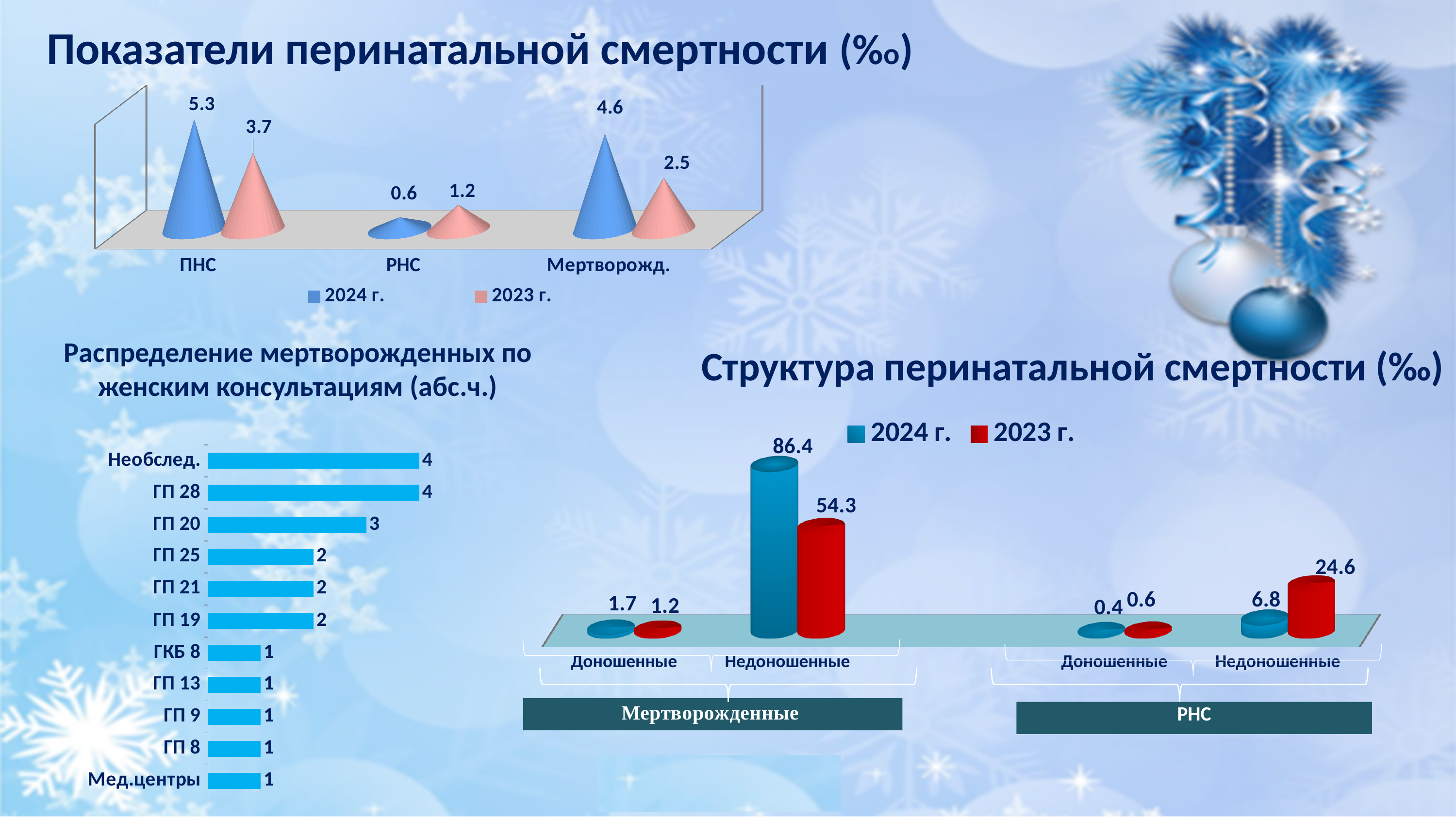
In the chart 'Структура перинатальной смертности (‰)', what is the difference between the 2024 г. and 2023 г. values for Недоношенные under Мертворожденные? 32.1 In the chart 'Распределение мертворожденных по женским консультациям (абс.ч.)', how many categories are shown? 11 In the chart 'Структура перинатальной смертности (‰)', what is the 2023 г. value for Недоношенные under РНС? 24.6 In the chart 'Показатели перинатальной смертности (‰)', which category has the lowest value for 2024 г.? РНС What kind of chart is 'Распределение мертворожденных по женским консультациям (абс.ч.)'? Bar chart In the chart 'Показатели перинатальной смертности (‰)', how many series does the legend list? 2 In the chart 'Показатели перинатальной смертности (‰)', what is the value for ПНС in 2024 г.? 5.3 In the chart 'Распределение мертворожденных по женским консультациям (абс.ч.)', what is the value for ГП 20? 3 In the chart 'Структура перинатальной смертности (‰)', what is the 2024 г. value for Недоношенные under Мертворожденные? 86.4 In the chart 'Показатели перинатальной смертности (‰)', what is the difference between the 2024 г. and 2023 г. values for Мертворожд.? 2.1 In the chart 'Показатели перинатальной смертности (‰)', what is the value for РНС in 2023 г.? 1.2 In the chart 'Распределение мертворожденных по женским консультациям (абс.ч.)', which is larger, the value for ГП 28 or the value for ГП 25? ГП 28